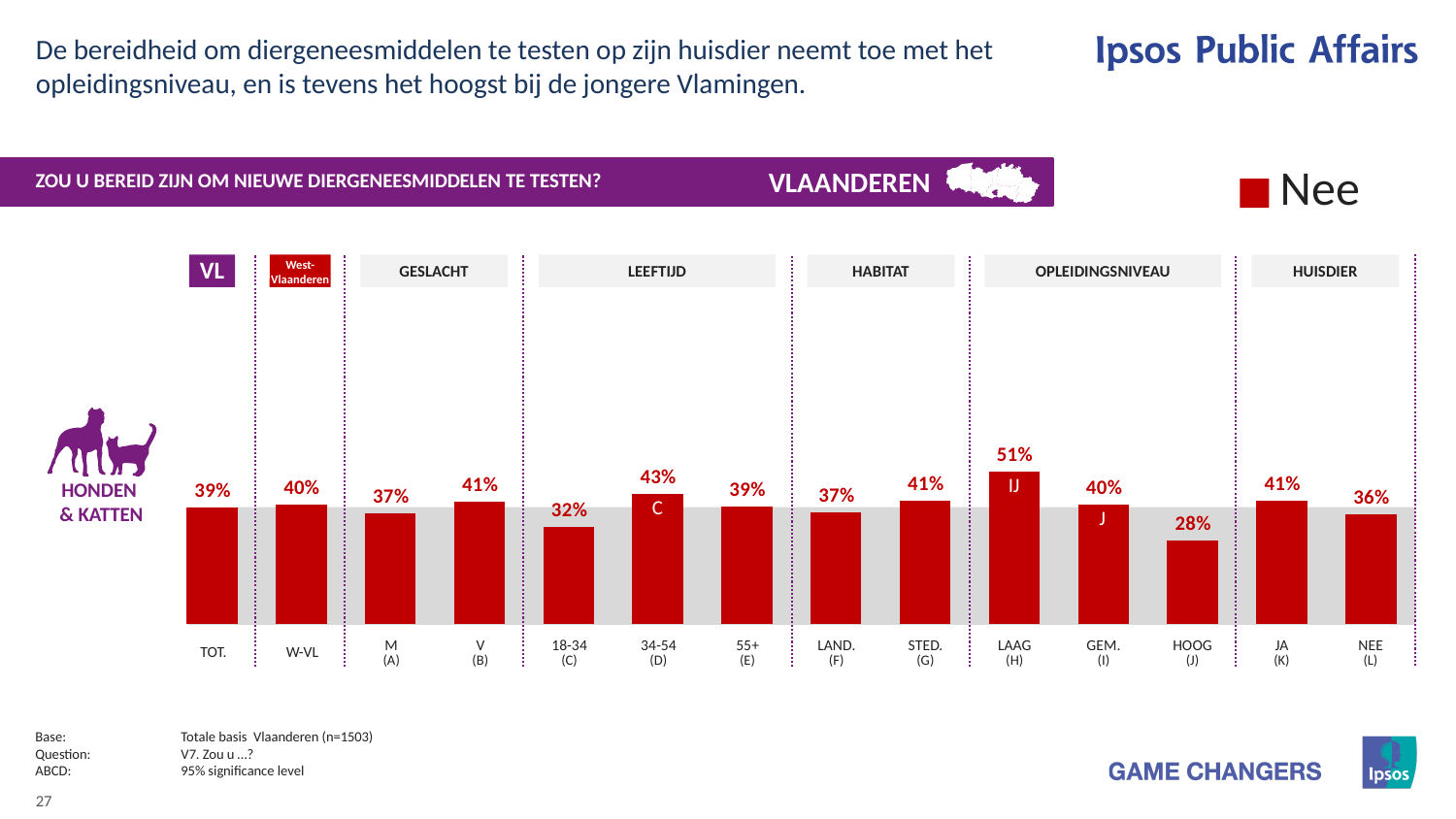
What kind of chart is shown on the slide? Bar chart What is the legend entry shown for the series? Nee What is the value for LAAG (H) under OPLEIDINGSNIVEAU? 51% How many series does the legend list? 1 Which category has the lowest value? HOOG (J) How many bars are plotted in the chart? 14 What is the value for TOT.? 39% What is the difference between the values for JA (K) and NEE (L)? 5% What is the value for the 18-34 (C) age group? 32% Which is larger, the value for M (A) or the value for V (B)? V (B) Which category has the highest value? LAAG (H) What is the difference between the values for LAAG (H) and HOOG (J)? 23%